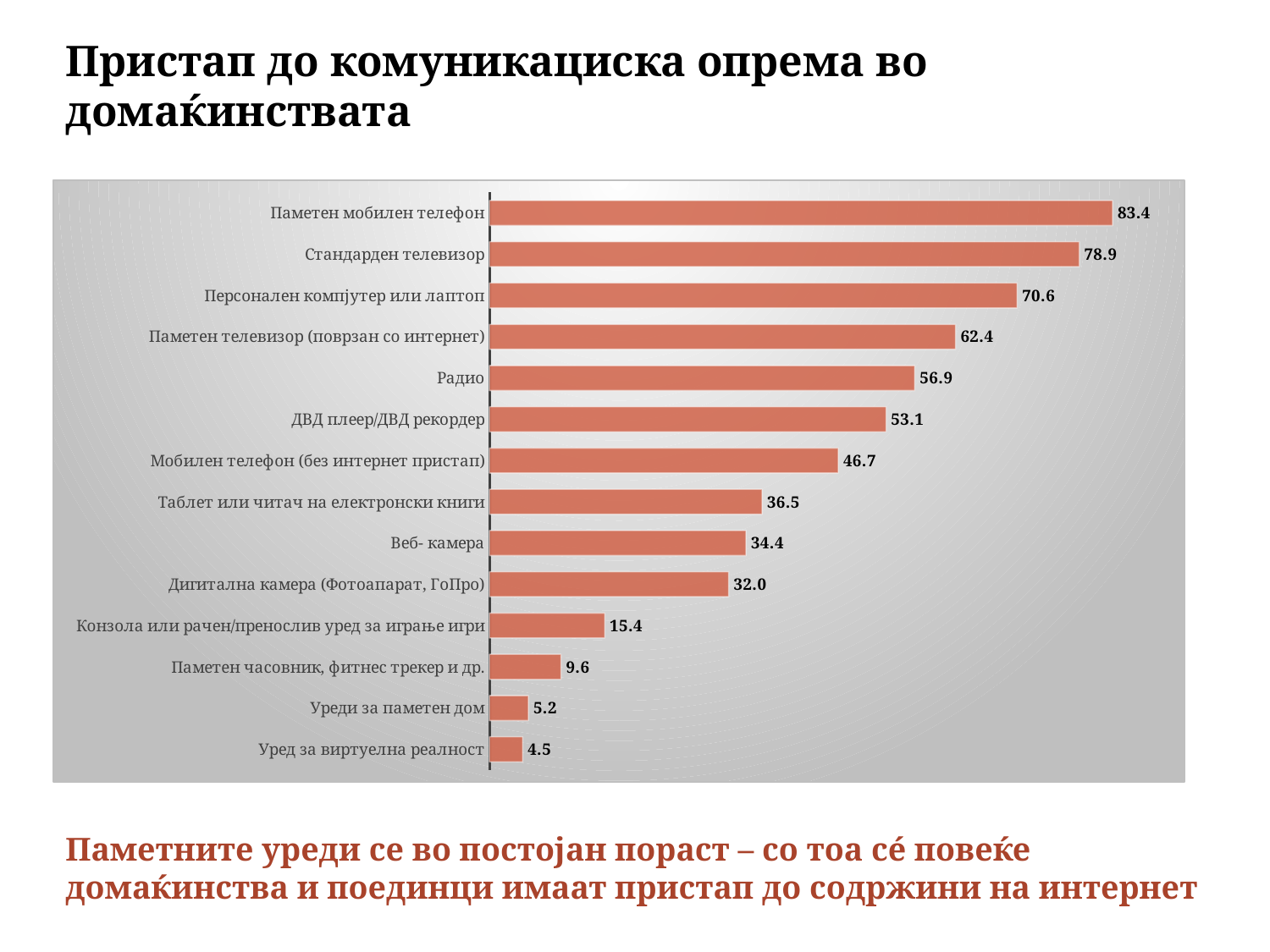
What is the title of the slide? Пристап до комуникациска опрема во домаќинствата What is the value for Паметен мобилен телефон? 83.4 What is the value for Уреди за паметен дом? 5.2 Which category has the highest value? Паметен мобилен телефон Which is larger, the value for ДВД плеер/ДВД рекордер or the value for Мобилен телефон (без интернет пристап)? ДВД плеер/ДВД рекордер What is the value for Веб- камера? 34.4 What is the difference between the values for Таблет или читач на електронски книги and Дигитална камера (Фотоапарат, ГоПро)? 4.5 What kind of chart is shown on the slide? Bar chart How many categories are shown in the chart? 14 What is the value for Радио? 56.9 What is the difference between the values for Стандарден телевизор and Паметен телевизор (поврзан со интернет)? 16.5 Which category has the lowest value? Уред за виртуелна реалност